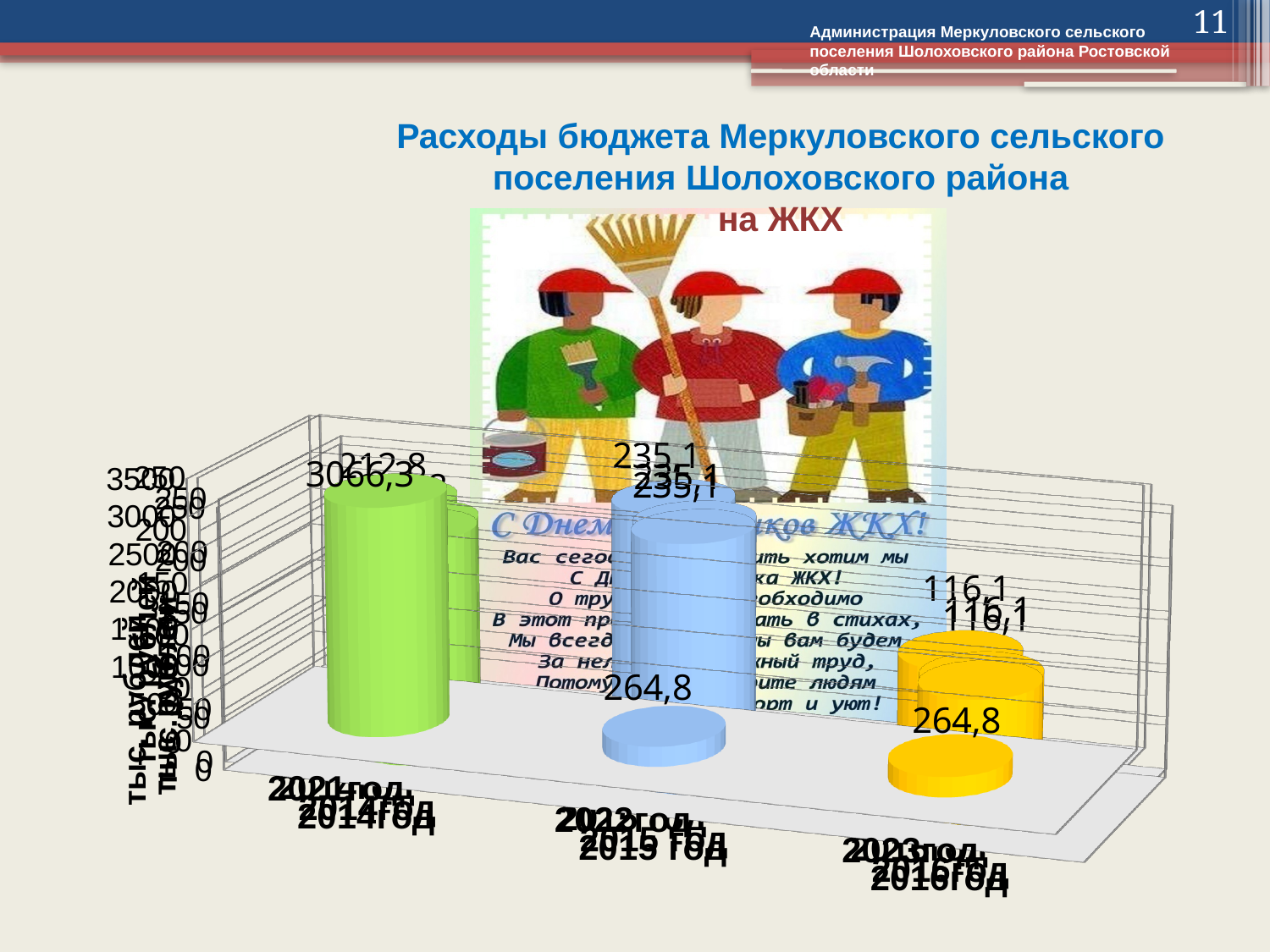
Which colour bar is the tallest in the chart? green Which is taller, the green bar or the yellow bar? green Which is taller, the blue bar or the yellow bar? blue What is the title of the chart? Расходы бюджета Меркуловского сельского поселения Шолоховского района на ЖКХ What colours are the three bars, from left to right? green, blue, yellow Which colour bar is the shortest in the chart? yellow What kind of chart is shown on the slide? bar chart